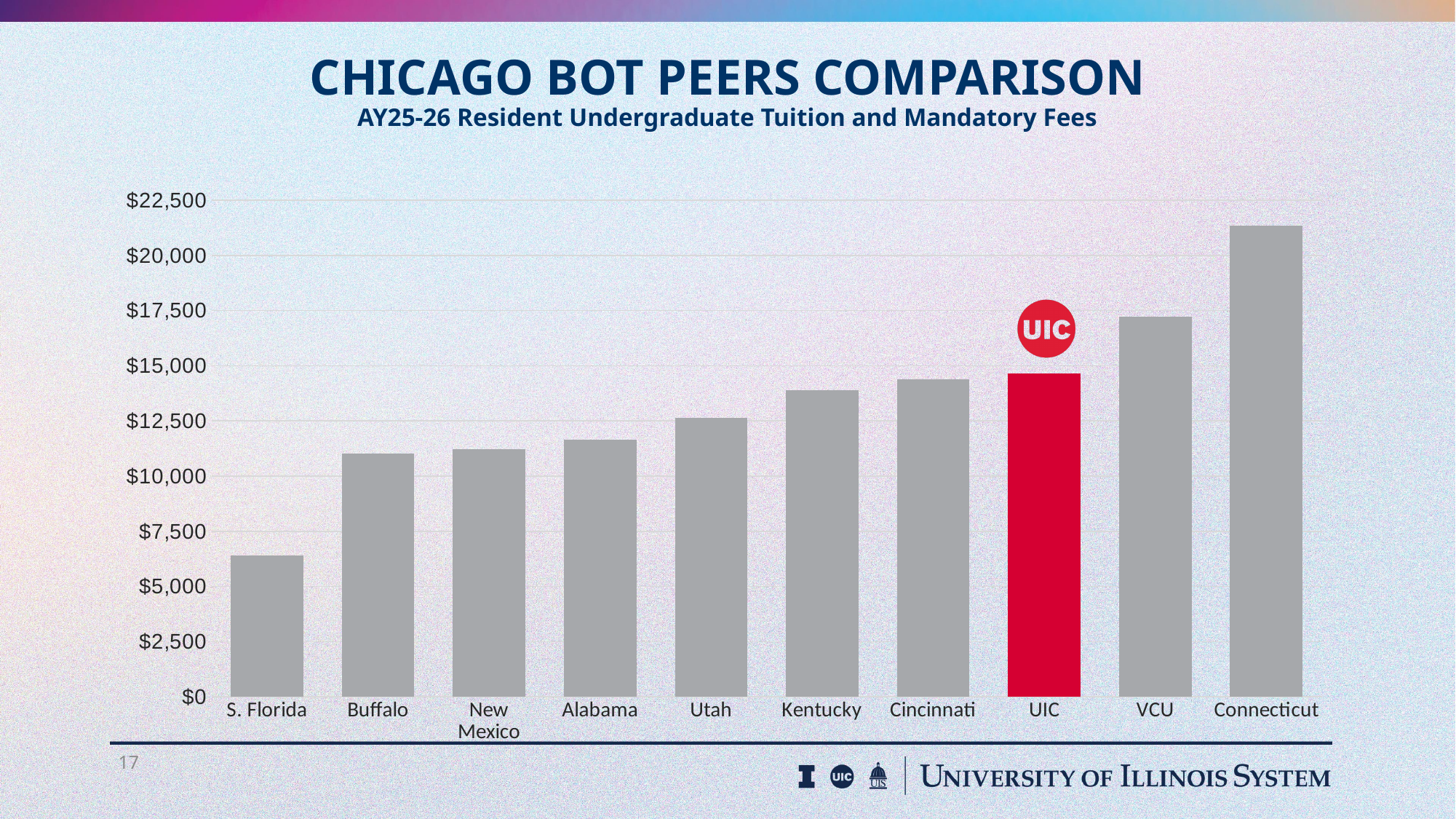
Is the value for Buffalo greater or less than $10,000? greater Is the value for UIC greater or less than $15,000? less Is the value for S. Florida greater or less than $7,500? less Which institution has the highest resident undergraduate tuition and mandatory fees in the chart? Connecticut Do the bar values generally rise or fall moving from left to right along the x axis? Rise Which institution has the lowest resident undergraduate tuition and mandatory fees in the chart? S. Florida How many institutions are shown on the x axis of the chart? 10 What kind of chart is shown on the slide? Bar chart Which is larger, the value for VCU or the value for UIC? VCU Which institution's bar is highlighted in red in the chart? UIC